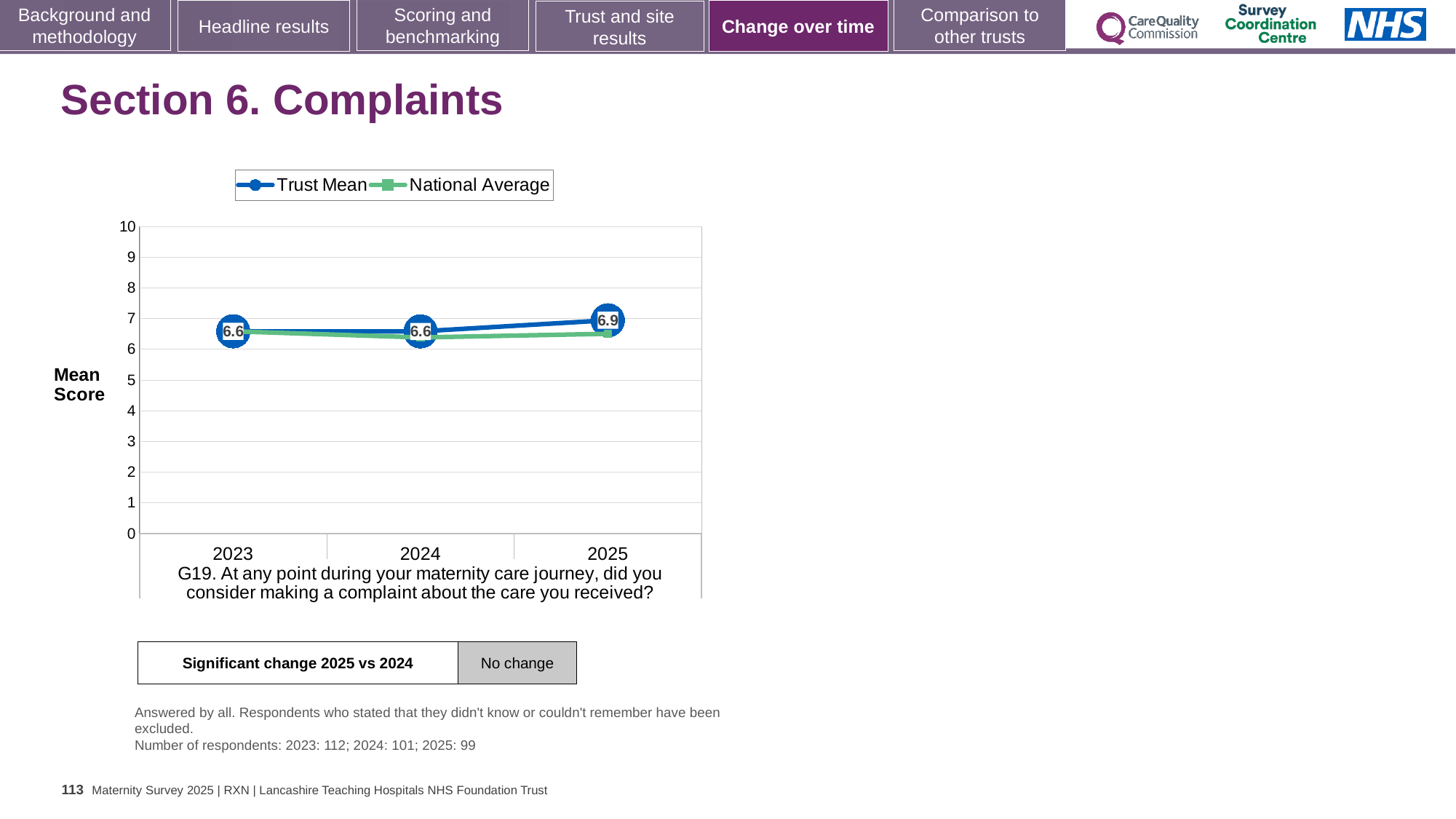
What kind of chart is shown on the slide? line chart Does the Trust Mean rise or fall from 2024 to 2025? rise What is the Trust Mean value for 2023? 6.6 How many years are plotted on the x axis? 3 How many series does the legend list? 2 Is the National Average value for 2025 greater or less than 5? greater In 2025, which series has the higher value, Trust Mean or National Average? Trust Mean Which is larger, the Trust Mean in 2025 or the Trust Mean in 2024? 2025 In which year is the Trust Mean highest? 2025 What is the Trust Mean value for 2024? 6.6 What is the Trust Mean value for 2025? 6.9 What is the difference between the Trust Mean in 2025 and in 2023? 0.3